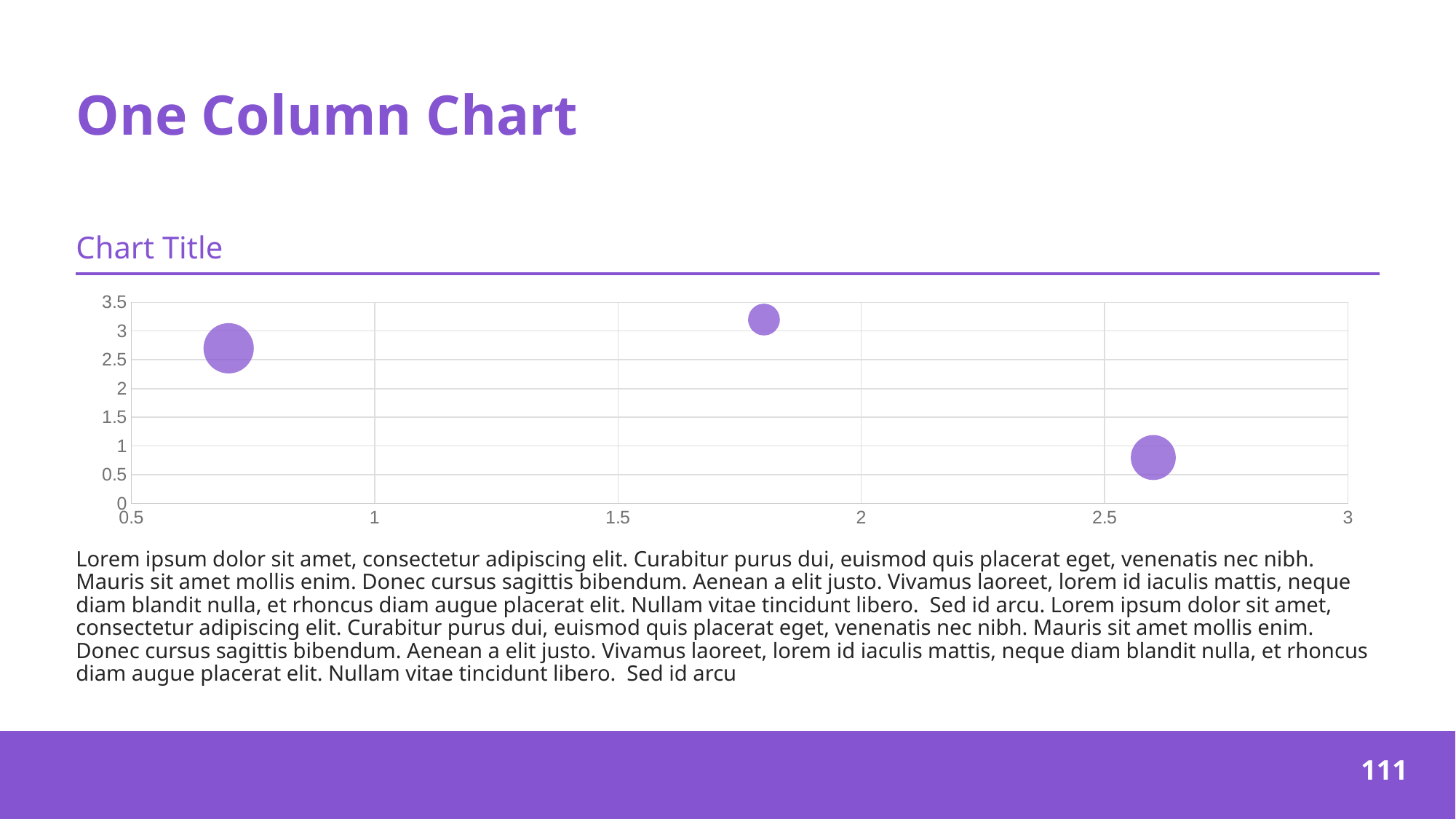
Which bubble has the lowest vertical (y-axis) position: the leftmost, the middle, or the rightmost? the rightmost Is the y-value of the middle bubble greater or less than 3? greater Which bubble has the highest vertical (y-axis) position: the leftmost, the middle, or the rightmost? the middle Is the y-value of the rightmost bubble greater or less than 1? less Which bubble is drawn largest in size? the leftmost Is the y-value of the leftmost bubble greater or less than 2? greater How many bubbles are plotted on the chart? 3 What kind of chart is shown on the slide? bubble chart Which bubble is higher on the y-axis, the leftmost or the rightmost? the leftmost What is the title shown above the chart? Chart Title What is the highest value shown on the y-axis? 3.5